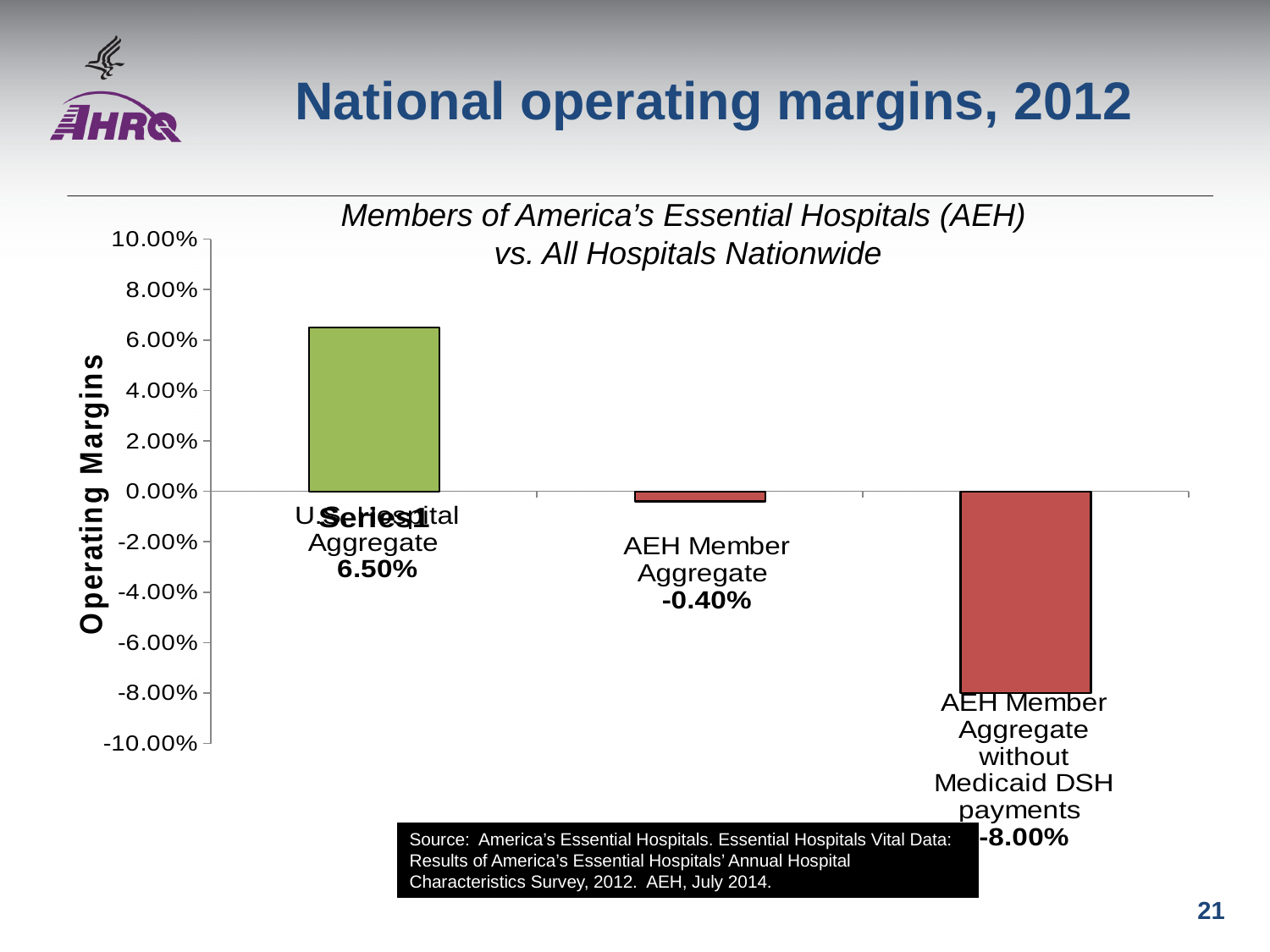
What is the operating margin shown for AEH Member Aggregate without Medicaid DSH payments? -8.00% What is the title of the vertical axis? Operating Margins Which category has the highest operating margin? U.S. Hospital Aggregate What is the operating margin shown for AEH Member Aggregate? -0.40% Which category has the lowest operating margin? AEH Member Aggregate without Medicaid DSH payments What kind of chart is shown on the slide? bar chart Which is larger: the operating margin for AEH Member Aggregate or for AEH Member Aggregate without Medicaid DSH payments? AEH Member Aggregate What value is labelled on the leftmost (green) bar, U.S. Hospital Aggregate? 6.50% How many categories (bars) are plotted in the chart? 3 What is the difference in percentage points between the U.S. Hospital Aggregate margin (6.50%) and the AEH Member Aggregate margin (-0.40%)? 6.90 percentage points By how many percentage points does the AEH Member Aggregate margin exceed the AEH Member Aggregate without Medicaid DSH payments margin? 7.60 percentage points Is the value for AEH Member Aggregate without Medicaid DSH payments greater or less than -6.00%? less